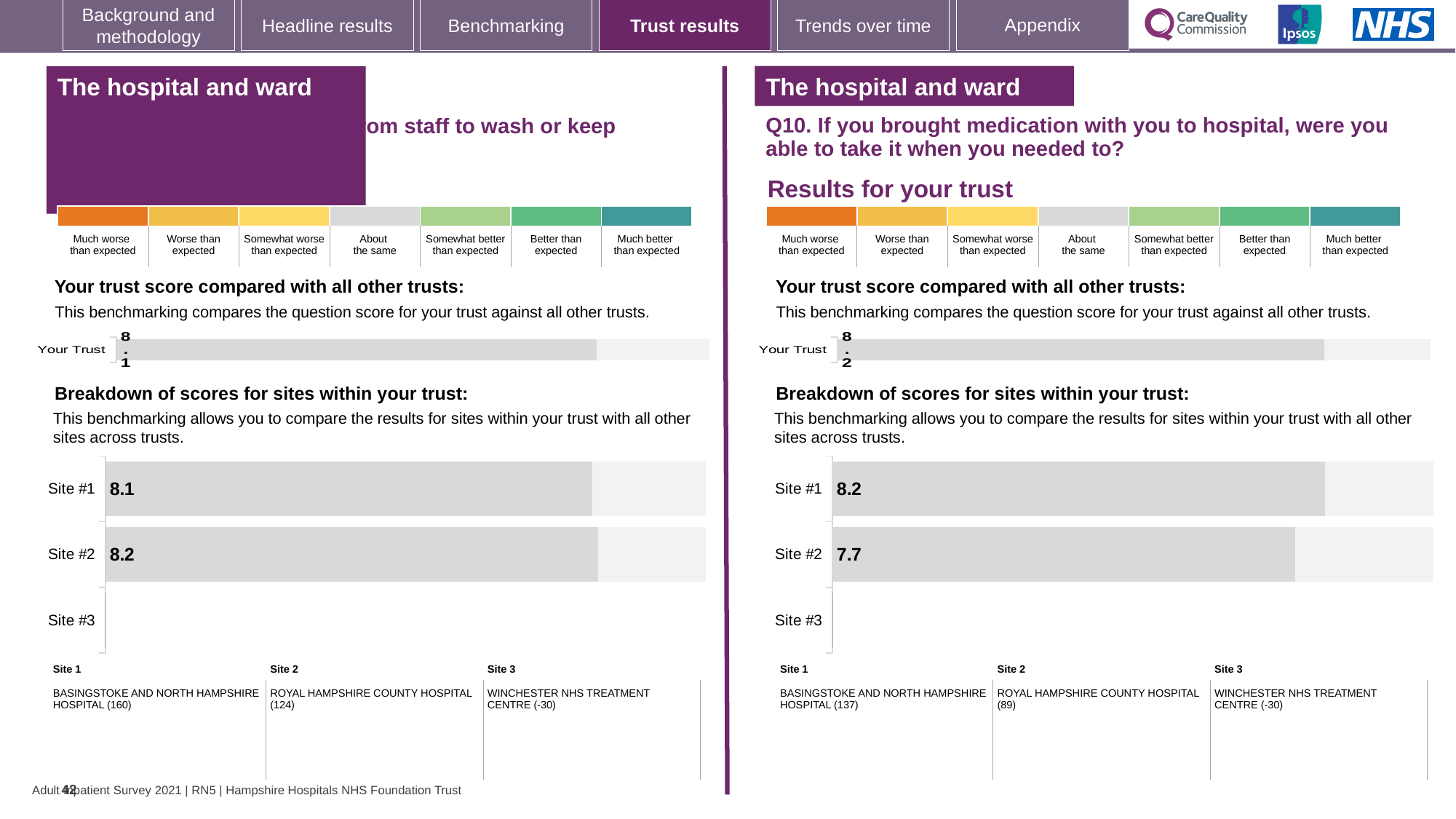
How many site categories are listed on the axis of the right-hand site breakdown chart (Q10)? 3 In the left-hand site breakdown chart, what is the difference between the scores for Site #2 and Site #1? 0.1 In the left-hand 'Breakdown of scores for sites within your trust' chart, what is the score for Site #2? 8.2 In the right-hand 'Breakdown of scores for sites within your trust' chart (Q10), what is the score for Site #2? 7.7 In the right-hand 'Breakdown of scores for sites within your trust' chart (Q10), what is the score for Site #1? 8.2 In the right-hand site breakdown chart (Q10), which site has no bar plotted? Site #3 In the right-hand 'Your trust score compared with all other trusts' chart (Q10), what is the score for Your Trust? 8.2 In the left-hand 'Breakdown of scores for sites within your trust' chart, what is the score for Site #1? 8.1 In the right-hand site breakdown chart (Q10), what is the difference between the scores for Site #1 and Site #2? 0.5 In the left-hand 'Your trust score compared with all other trusts' chart, what is the score for Your Trust? 8.1 What type of chart is used for the site breakdown on the right-hand side (Q10)? Bar chart In the right-hand site breakdown chart (Q10), which site has the higher score, Site #1 or Site #2? Site #1